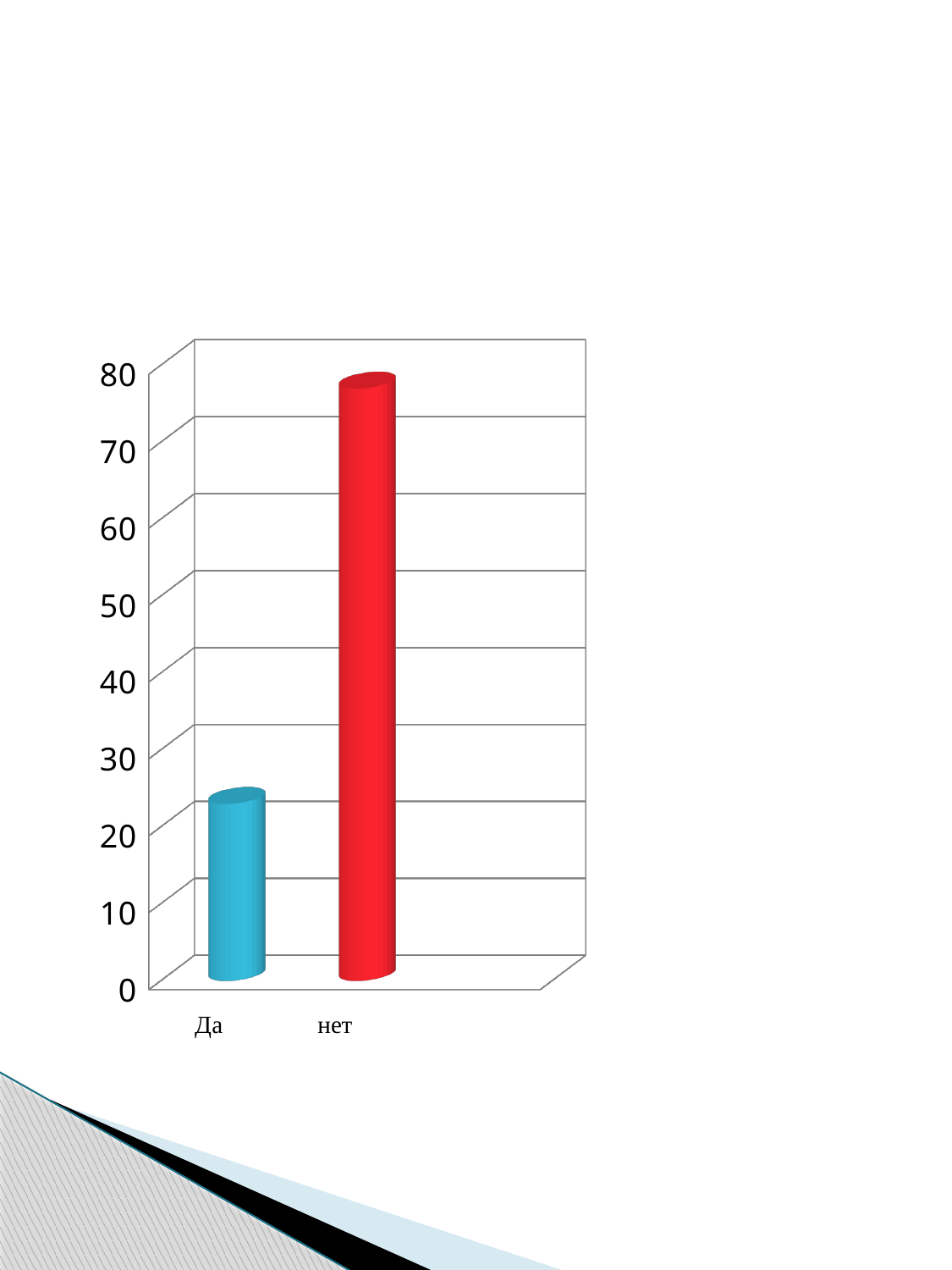
Is the value for нет greater or less than 80? less Which category has the highest value? нет Is the value for Да greater or less than 30? less Is the value for нет greater or less than 70? greater What kind of chart is shown on the slide? bar chart What colour is the bar for нет? red Which is larger, the value for Да or the value for нет? нет How many categories are shown on the x axis? 2 Which category has the lowest value? Да What colour is the bar for Да? blue